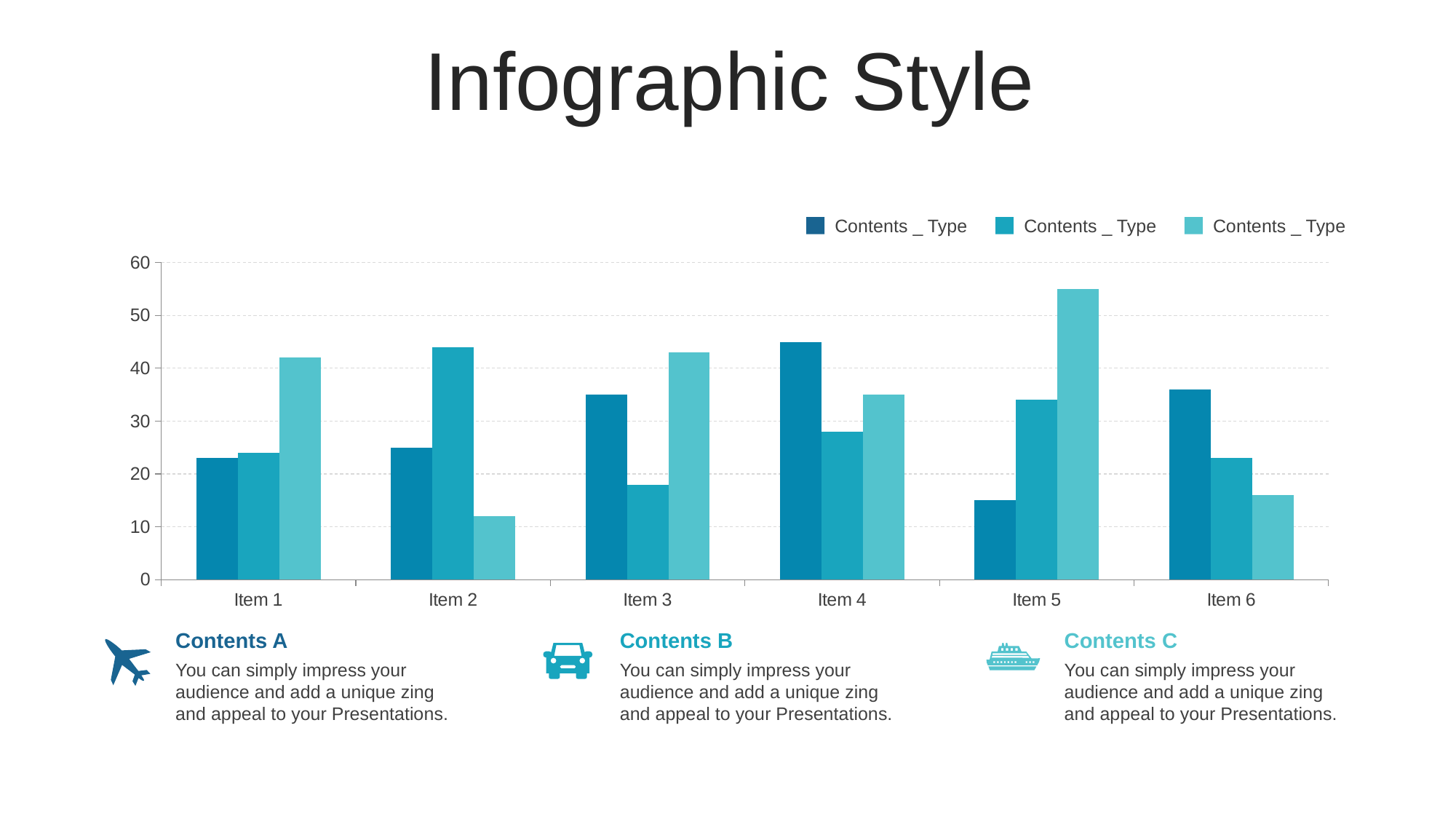
What kind of chart is shown on the slide? Bar chart What text is used for each of the three legend entries in the chart? Contents _ Type How many series does the chart's legend list? 3 Is the value of the dark blue bar for Item 4 greater or less than 40? greater Is the value of the light teal bar for Item 5 greater or less than 50? greater Which item has the tallest dark blue bar? Item 4 Which item has the tallest light teal bar? Item 5 For Item 3, which is larger: the dark blue bar or the medium blue bar? The dark blue bar Is the value of the medium blue bar for Item 2 greater or less than 40? greater How many item categories are shown on the x axis of the chart? 6 Which item has the shortest dark blue bar? Item 5